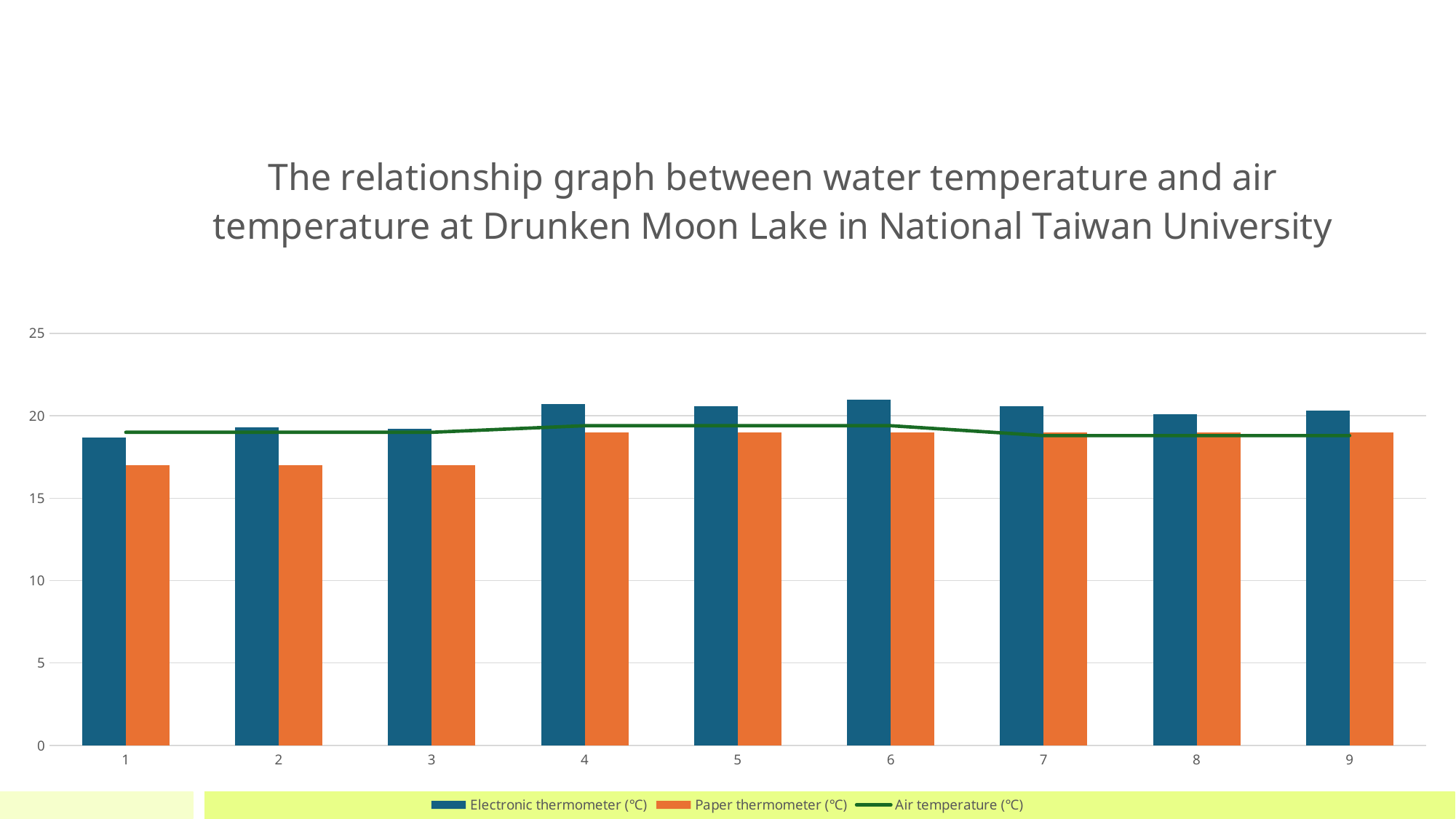
Is the Paper thermometer value for category 2 greater or less than 20? less Is the Paper thermometer value for category 5 greater or less than 15? greater Is the Electronic thermometer value for category 1 greater or less than 20? less How many categories are shown on the x axis? 9 How many series does the legend list? 3 For category 1, which is larger: the Electronic thermometer value or the Paper thermometer value? Electronic thermometer Which category has the lowest Electronic thermometer value? 1 Which is larger: the Paper thermometer value for category 4 or for category 1? Category 4 Which series is drawn as a line rather than bars? Air temperature (°C) What kind of chart is shown on the slide? Bar chart with a line series Which series is shown in orange? Paper thermometer (°C)